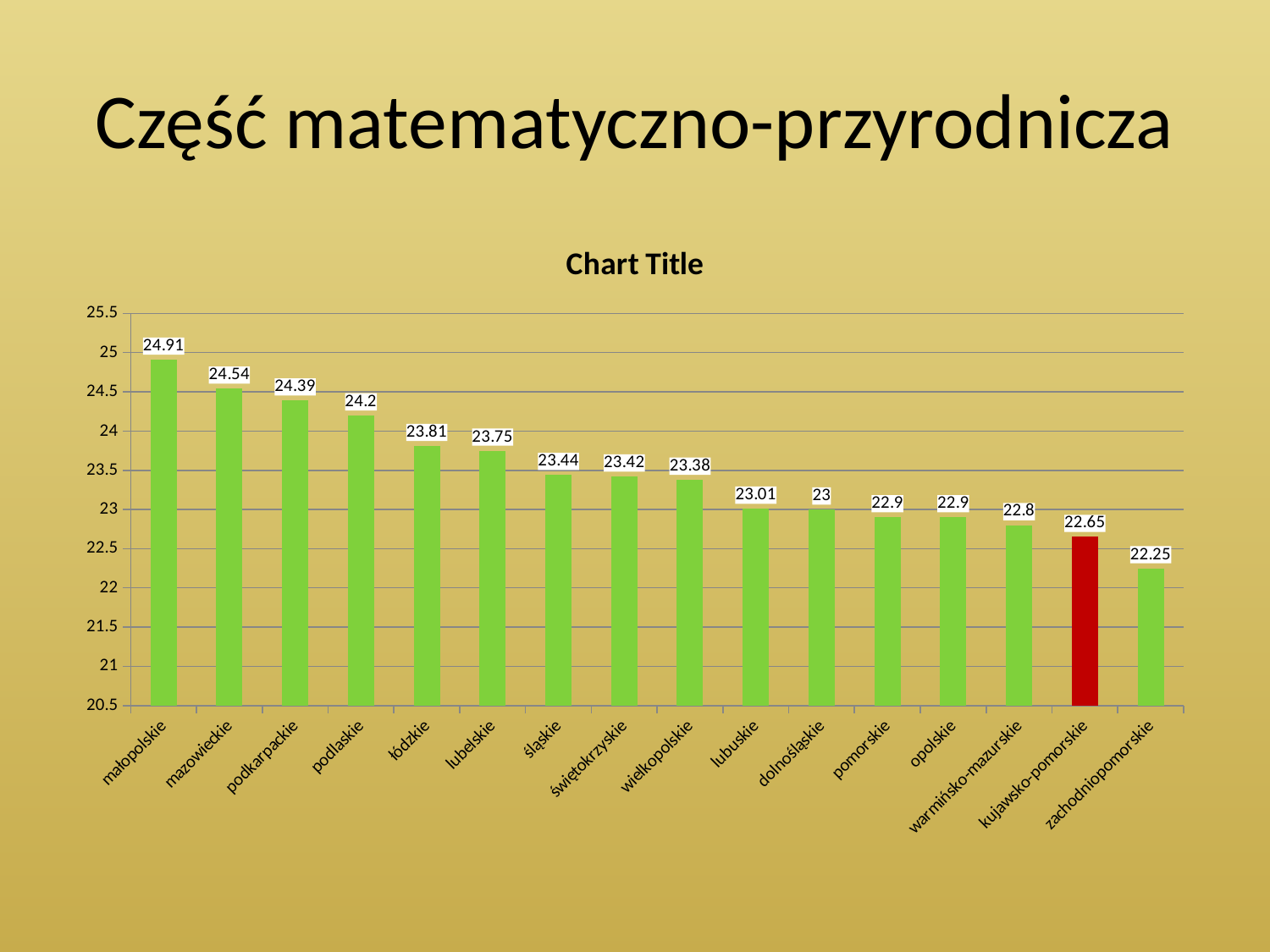
Which category has the lowest value? zachodniopomorskie Which category has the highest value? małopolskie How many categories are shown on the x axis? 16 What is the difference between the values for małopolskie and zachodniopomorskie? 2.66 What is the value for lubuskie? 23.01 What is the value for małopolskie? 24.91 What is the value for kujawsko-pomorskie? 22.65 What kind of chart is shown on the slide? bar chart What is the difference between the values for mazowieckie and podkarpackie? 0.15 Which bar is coloured red instead of green? kujawsko-pomorskie Which is larger, the value for łódzkie or the value for lubelskie? łódzkie Is the value for podlaskie greater or less than 24? greater